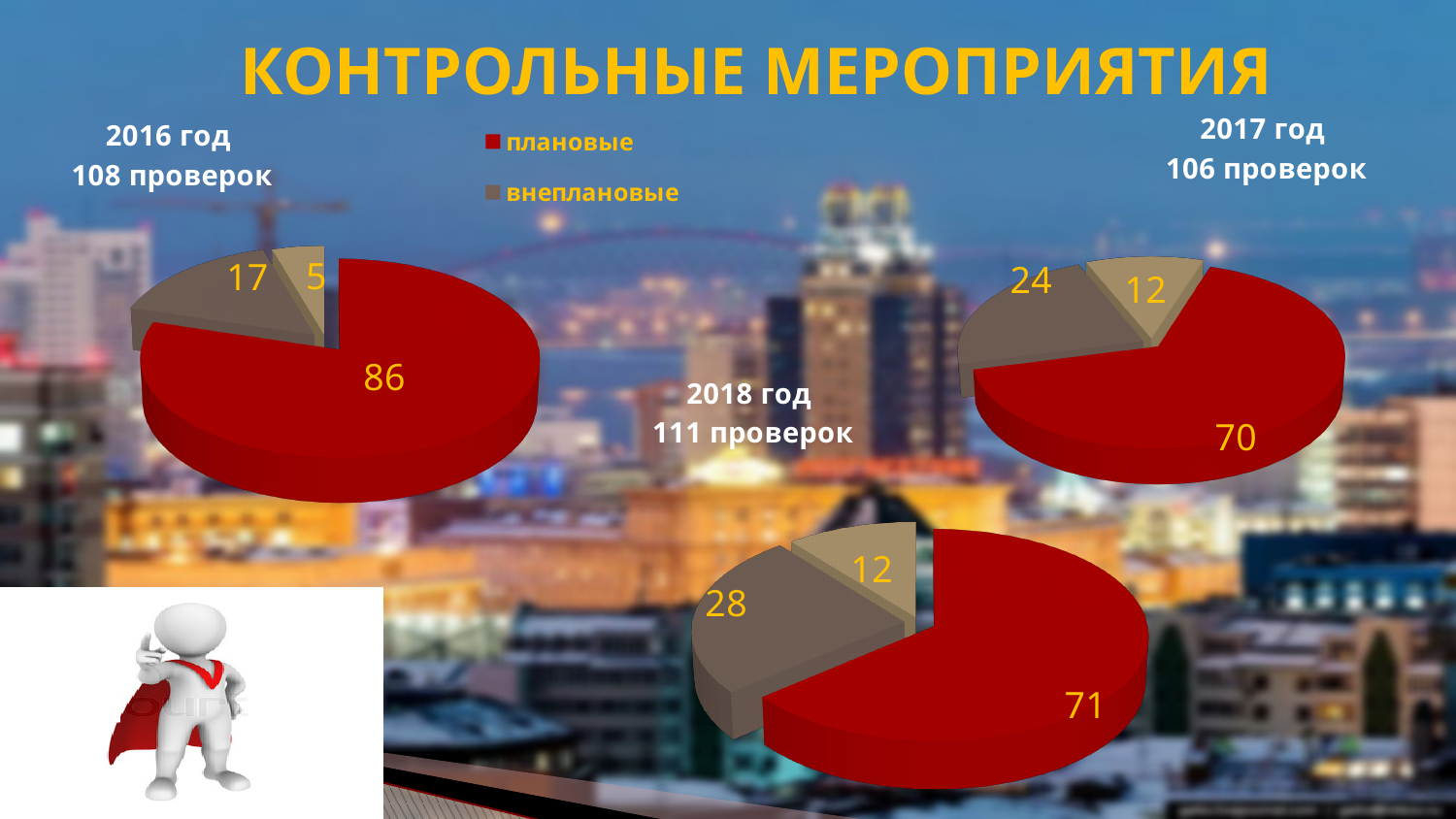
In the 2016 pie chart, what is the difference between the slices labelled 86 and 17? 69 In the 2017 pie chart, what is the difference between the largest slice (70) and the slice labelled 24? 46 In the 2016 pie chart, what is the value of the largest slice? 86 In the 2018 pie chart, what is the smallest slice value? 12 How many slices does the 2018 pie chart have? 3 In the 2016 pie chart, what is the smallest slice value? 5 What type of chart is used for the 2016 data? Pie chart In the 2018 pie chart, what is the value of the red (плановые) slice? 71 Which is larger: the red slice in the 2018 pie chart or the red slice in the 2017 pie chart? 2018 (71) In the 2017 pie chart, what is the value of the red (плановые) slice? 70 How many entries does the legend list? 2 What is the title of the slide containing the pie charts? КОНТРОЛЬНЫЕ МЕРОПРИЯТИЯ